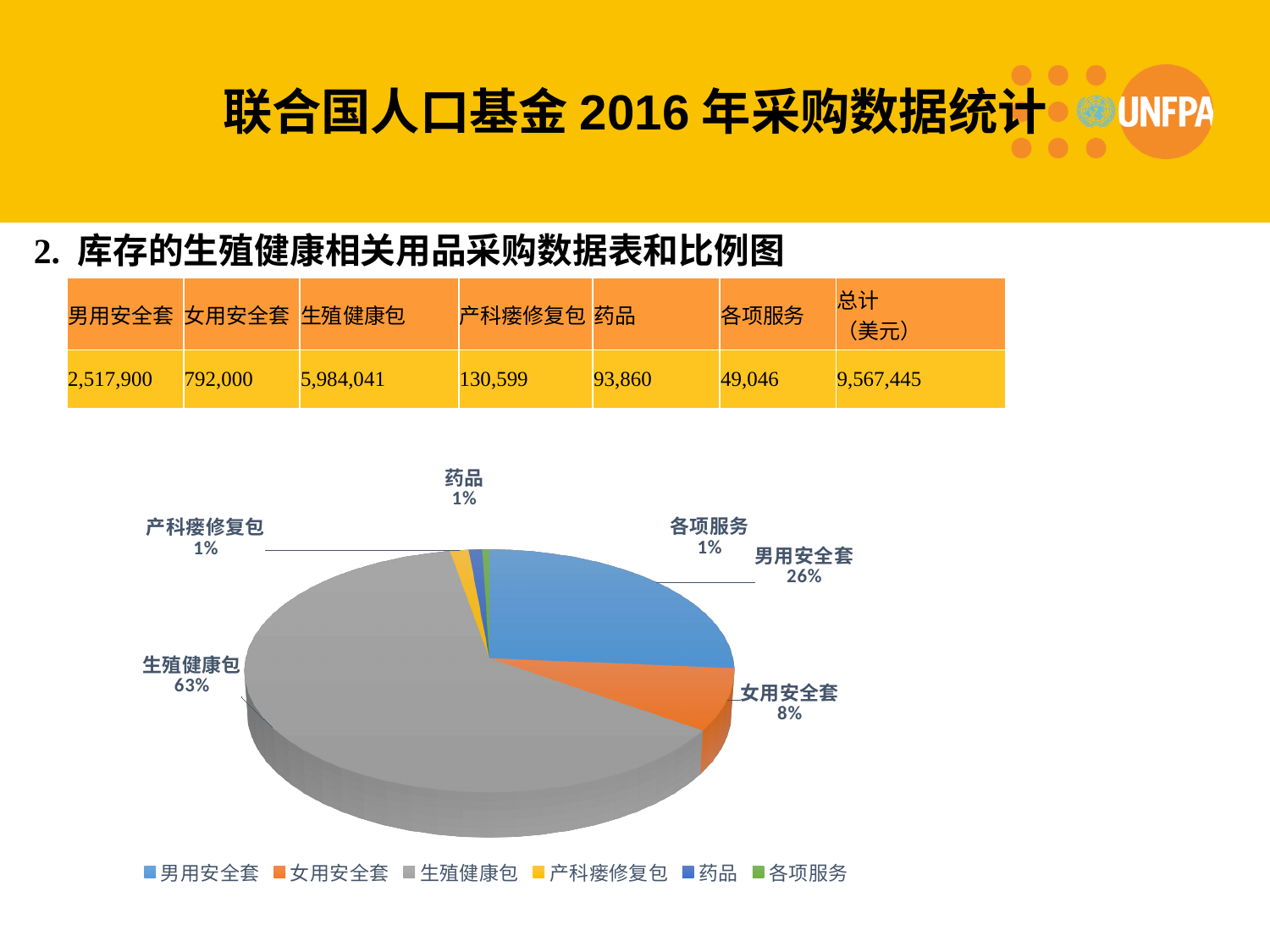
What share of the pie does 生殖健康包 represent? 63% How many categories does the pie chart legend list? 6 What is the difference in percentage points between the 生殖健康包 slice and the 男用安全套 slice? 37 What share of the pie does 药品 represent? 1% Which category has the largest slice of the pie? 生殖健康包 What colour is the 生殖健康包 slice in the pie chart? Grey What share of the pie does 女用安全套 represent? 8% What kind of chart is shown on the slide? Pie chart Which is larger in the pie chart, 男用安全套 or 女用安全套? 男用安全套 What colour is the 男用安全套 slice in the pie chart? Blue How many slices are labelled 1% in the pie chart? 3